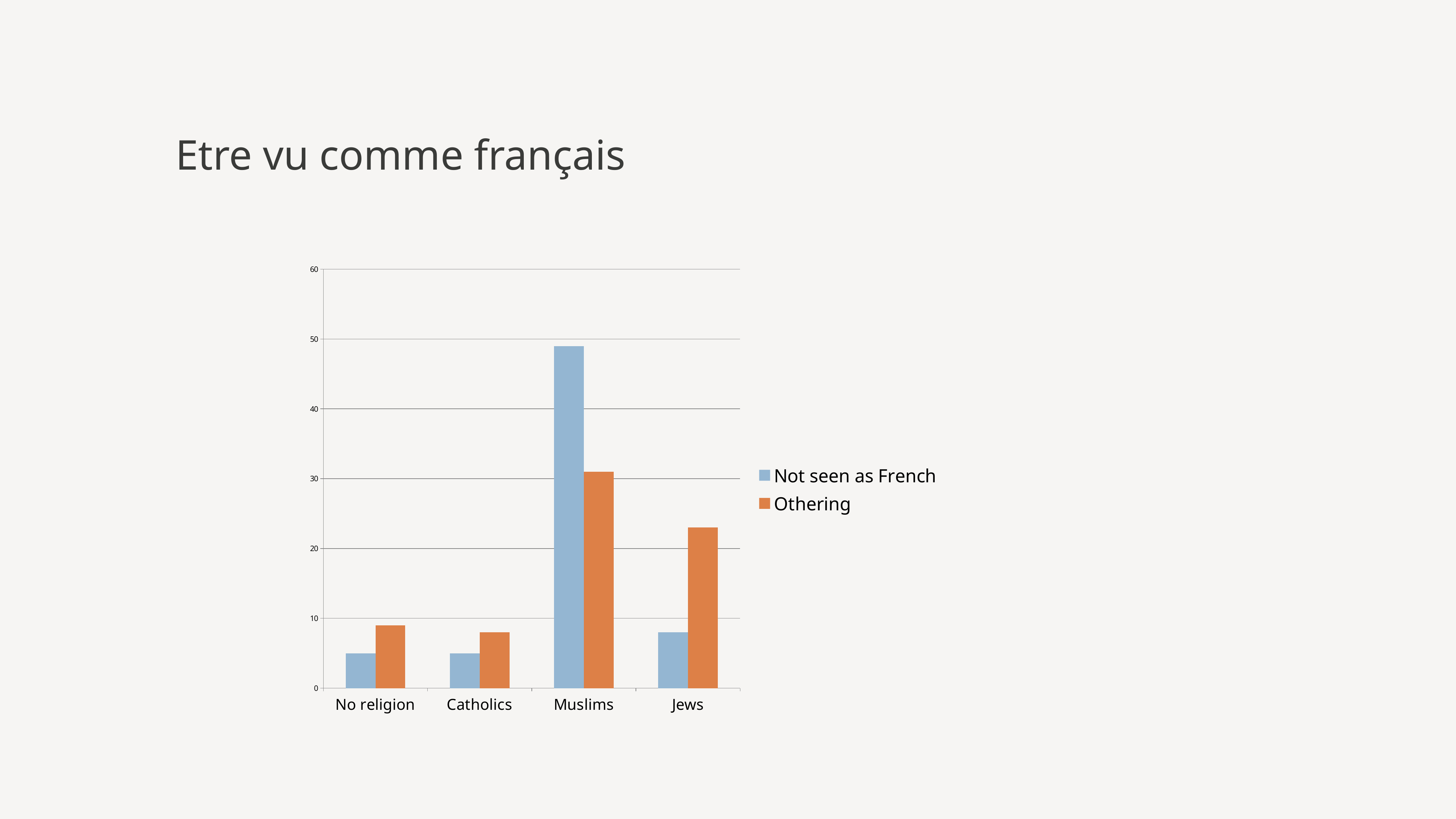
What kind of chart is shown on the slide? bar chart What colour represents the 'Othering' series in the chart? orange How many categories are shown on the x axis of the chart? 4 How many series does the chart's legend list? 2 Which category has the highest value for 'Not seen as French'? Muslims Which category has the lowest value for 'Othering'? Catholics For Muslims, which series has the larger value: 'Not seen as French' or 'Othering'? Not seen as French Which category has the highest value for 'Othering'? Muslims Is the 'Not seen as French' value for Jews greater or less than 10? less For Jews, which series has the larger value: 'Not seen as French' or 'Othering'? Othering Is the 'Othering' value for Jews greater or less than 20? greater Is the 'Not seen as French' value for Muslims greater or less than 40? greater